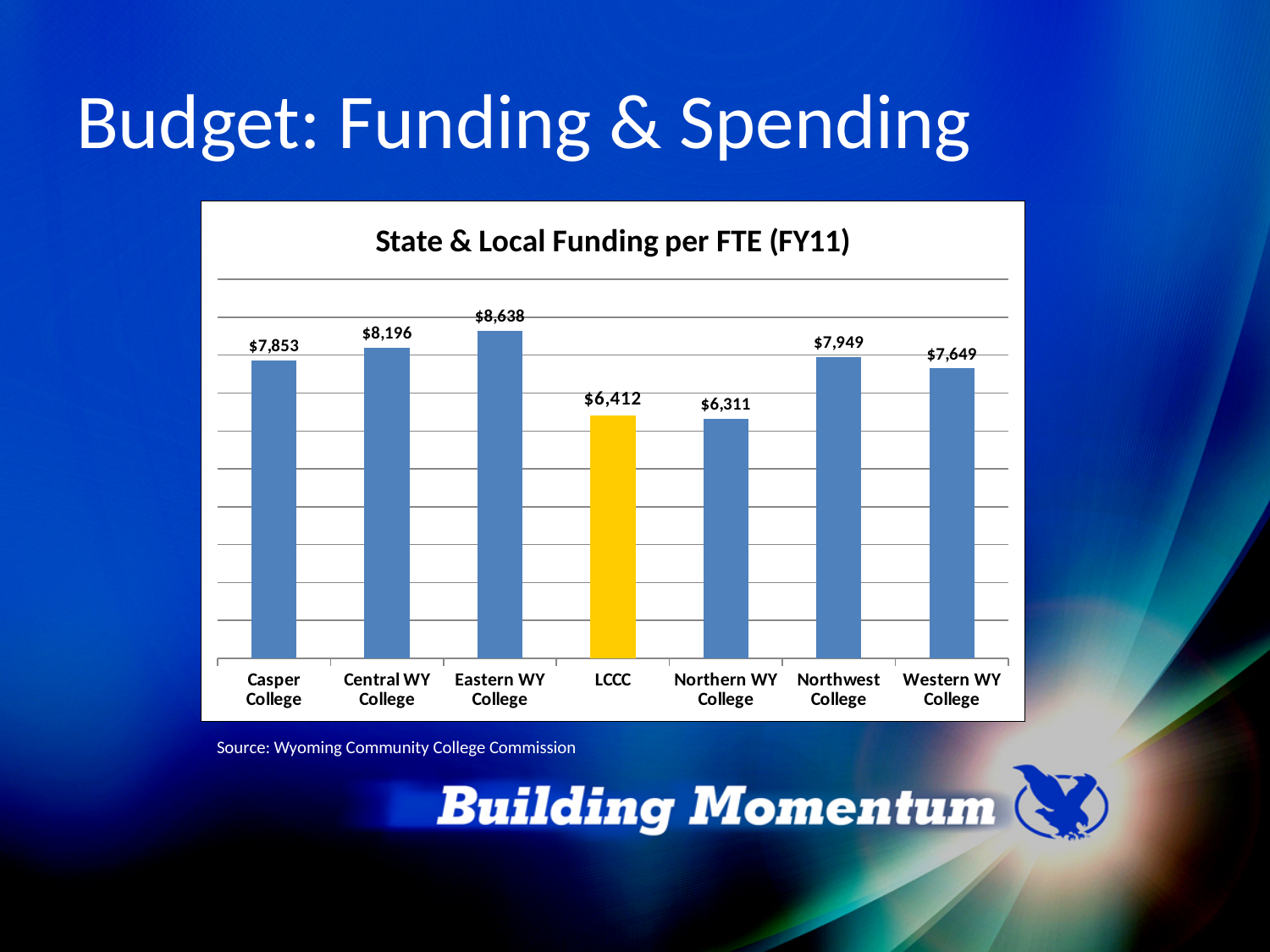
How many colleges are shown in the chart? 7 What is the State & Local Funding per FTE for LCCC? $6,412 Which has higher funding per FTE, LCCC or Northern WY College? LCCC What is the difference between Eastern WY College's and LCCC's funding per FTE? $2,226 Which college's bar is highlighted in yellow? LCCC What is the State & Local Funding per FTE for Casper College? $7,853 Which college has the lowest State & Local Funding per FTE? Northern WY College What is the difference between Central WY College's and Western WY College's funding per FTE? $547 What type of chart is shown on the slide? Bar chart Which has higher funding per FTE, Casper College or Northwest College? Northwest College What is the State & Local Funding per FTE for Northwest College? $7,949 Which college has the highest State & Local Funding per FTE? Eastern WY College